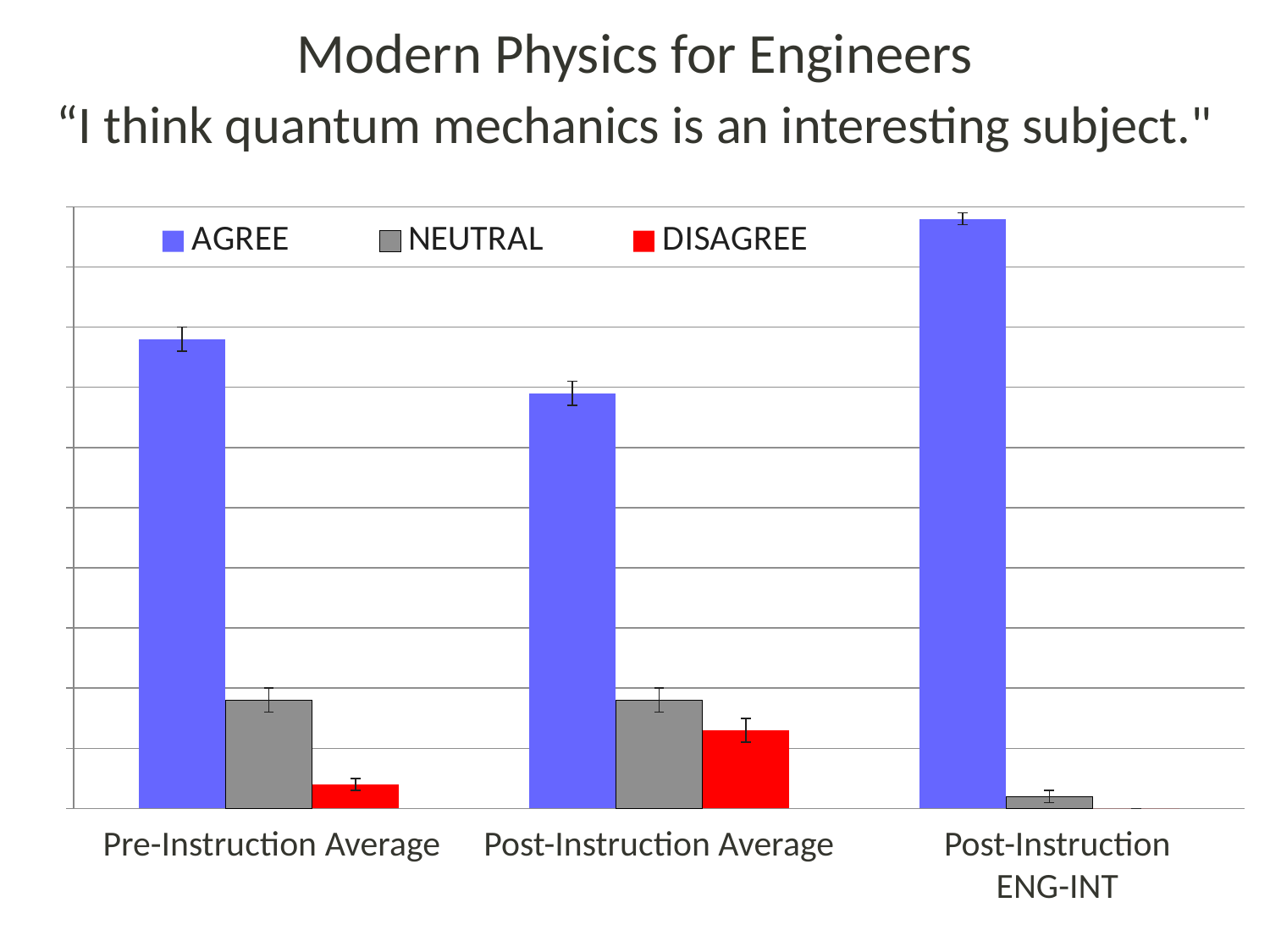
Which category has the tallest AGREE bar? Post-Instruction ENG-INT Is the DISAGREE value larger for Pre-Instruction Average or Post-Instruction Average? Post-Instruction Average Which category has the lowest DISAGREE bar? Post-Instruction ENG-INT Is the AGREE value larger for Pre-Instruction Average or Post-Instruction Average? Pre-Instruction Average Which series has the highest value in the Pre-Instruction Average category? AGREE How many categories are shown along the x axis? 3 What kind of chart is shown on the slide? bar chart Does the AGREE value rise or fall from Pre-Instruction Average to Post-Instruction Average? fall What colour are the DISAGREE bars? red Which series has the lowest value in the Post-Instruction Average category? DISAGREE How many series does the legend list? 3 What statement is quoted in the slide title above the chart? "I think quantum mechanics is an interesting subject."